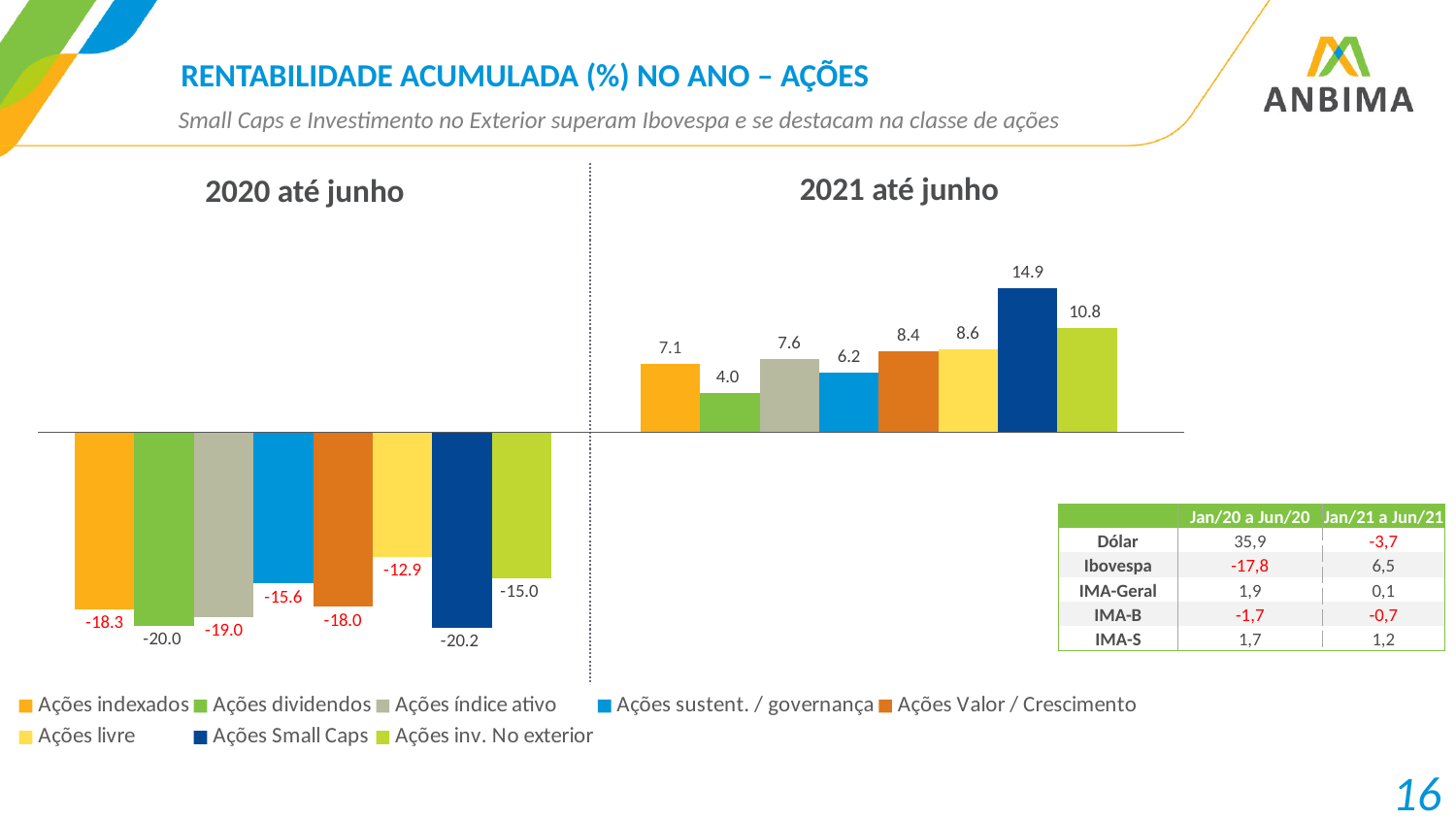
In the "2021 até junho" chart, what is the value for Ações dividendos? 4.0 In the "2021 até junho" chart, what is the value for Ações Small Caps? 14.9 In the "2020 até junho" chart, which is larger, the value for Ações sustent. / governança or the value for Ações Valor / Crescimento? Ações sustent. / governança In the "2020 até junho" chart, what is the difference between Ações livre and Ações Small Caps? 7.3 In the "2020 até junho" chart, what is the value for Ações livre? -12.9 In the "2021 até junho" chart, what is the difference between Ações Small Caps and Ações inv. No exterior? 4.1 How many series does the legend list? 8 How many categories are plotted in the "2021 até junho" chart? 8 What kind of chart is the "2020 até junho" chart? Bar chart In the "2021 até junho" chart, which category has the lowest value? Ações dividendos In the "2020 até junho" chart, which category has the lowest value? Ações Small Caps In the "2021 até junho" chart, which category has the highest value? Ações Small Caps